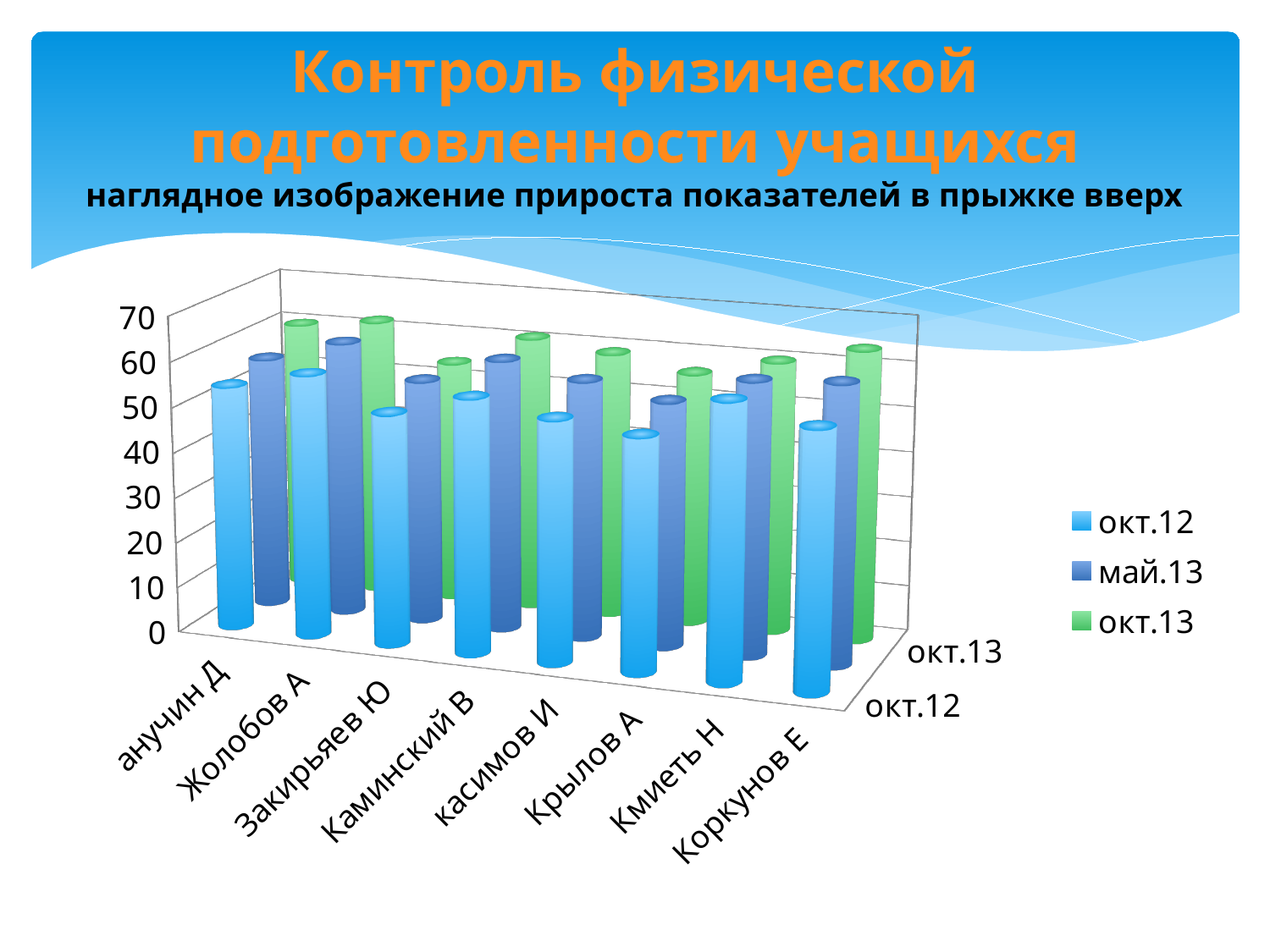
How many students (categories) are shown on the x axis of the chart? 8 Is the окт.12 value for Коркунов Е greater or less than 30? greater What are the three series listed in the chart legend? окт.12, май.13, окт.13 Is the окт.12 value for анучин Д greater or less than 40? greater Is the окт.12 value for Жолобов А greater or less than 40? greater What is the highest value shown on the vertical axis of the chart? 70 What kind of chart is shown on the slide? bar chart What is the subtitle describing the chart on the slide? наглядное изображение прироста показателей в прыжке вверх How many series does the chart legend list? 3